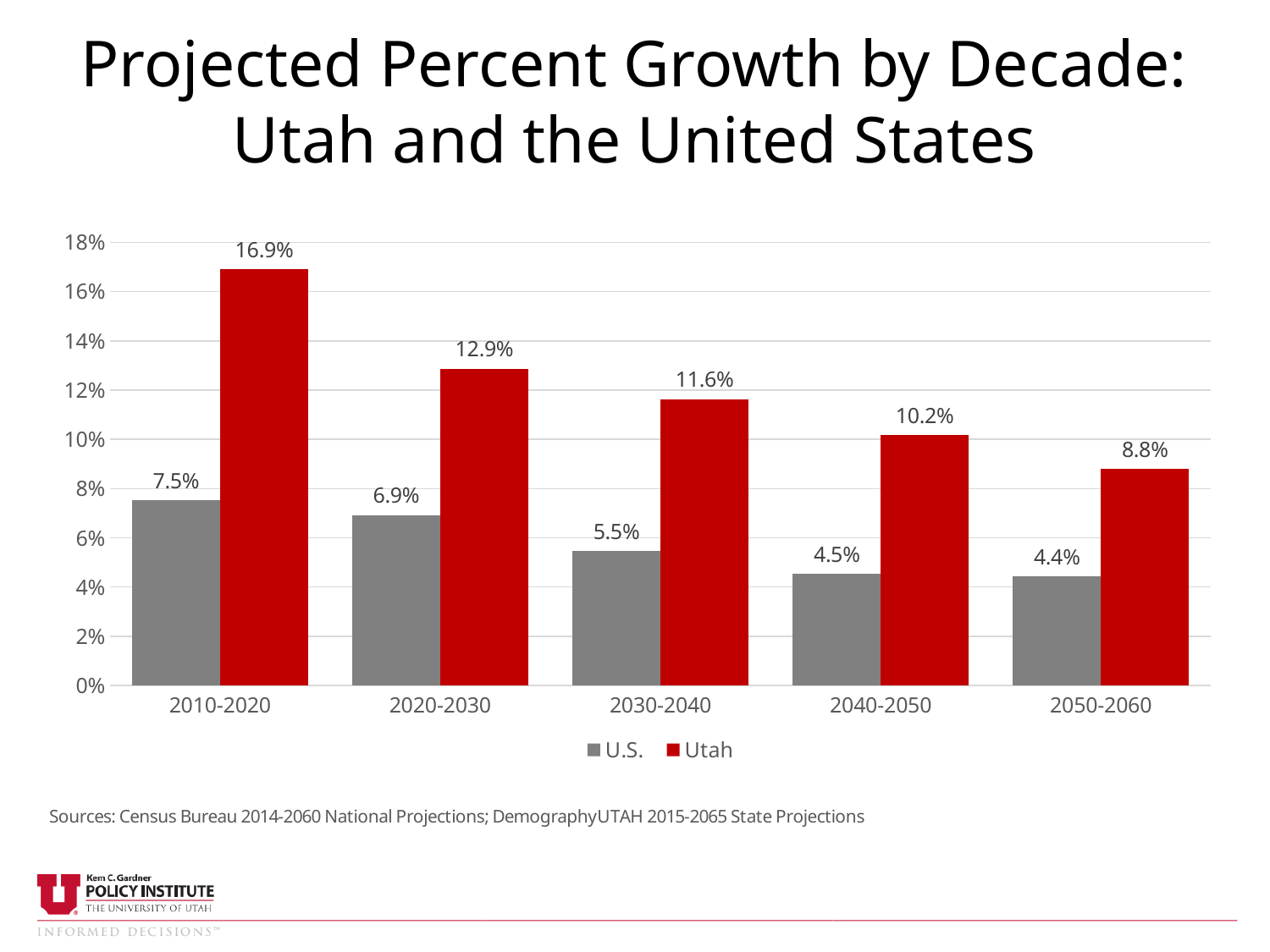
Which decade has the highest projected percent growth for Utah? 2010-2020 Do the projected percent growth values for Utah rise or fall across the decades from 2010-2020 to 2050-2060? Fall Which is larger in 2040-2050, the projected growth for Utah or for the U.S.? Utah What is the projected percent growth for the U.S. in 2030-2040? 5.5% How many decades are shown on the x axis? 5 What kind of chart is shown on the slide? Bar chart What is the projected percent growth for Utah in 2010-2020? 16.9% Is the projected percent growth for Utah in 2030-2040 greater or less than 10%? greater How many series does the legend list? 2 What is the difference between Utah's and the U.S.'s projected percent growth in 2020-2030? 6.0% Which decade has the lowest projected percent growth for the U.S.? 2050-2060 What is the projected percent growth for Utah in 2050-2060? 8.8%